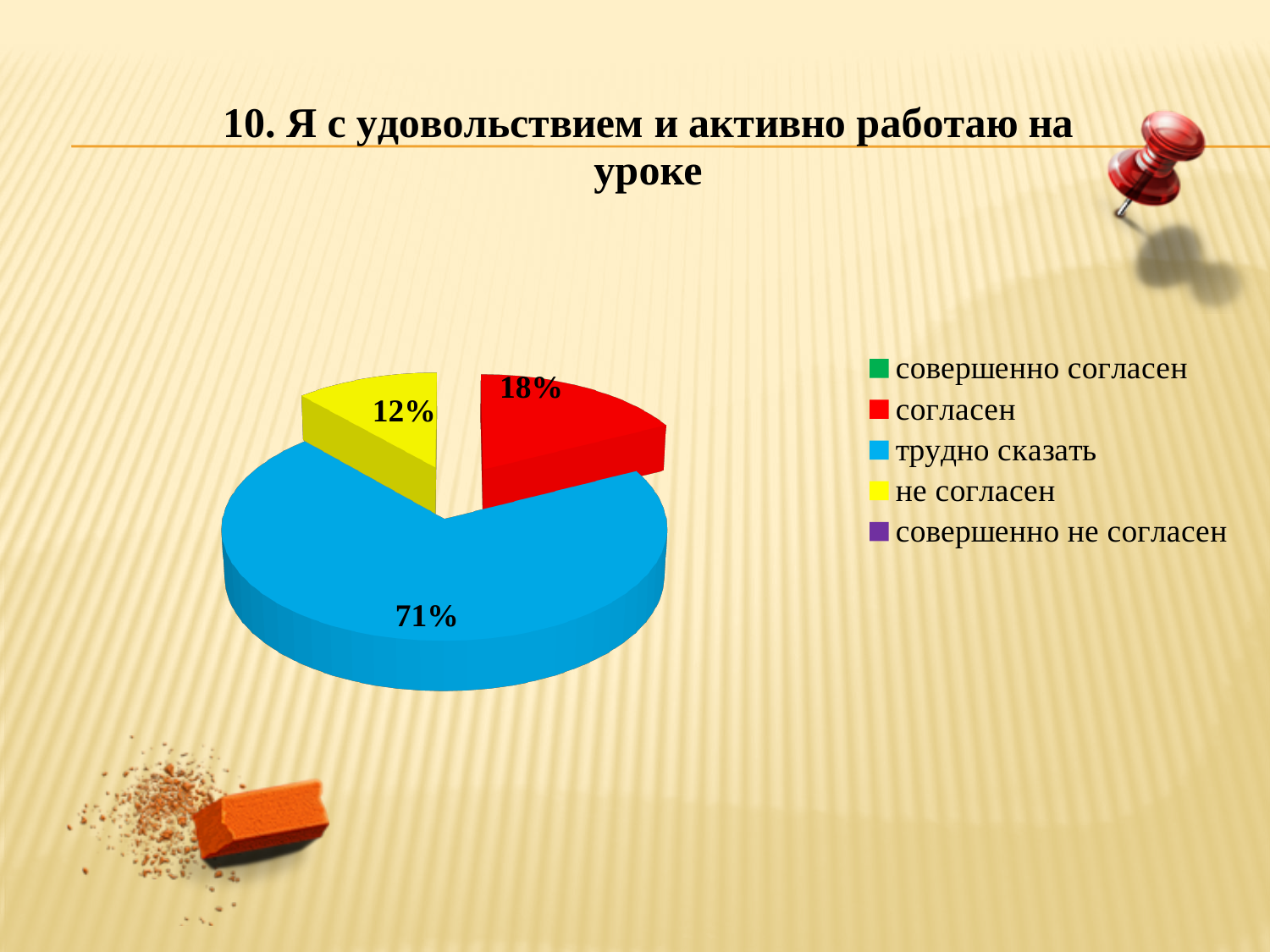
Which category has the largest slice of the pie? трудно сказать Which is larger, the slice for "согласен" or the slice for "не согласен"? согласен What is the difference between the shares for "трудно сказать" and "согласен"? 53% What share of the pie does "не согласен" have? 12% What is the difference between the shares for "согласен" and "не согласен"? 6% How many entries does the legend list? 5 What share of the pie does "трудно сказать" have? 71% Which of the labelled slices is the smallest? не согласен What kind of chart is shown on the slide? pie chart What colour is the slice for "трудно сказать"? blue What share of the pie does "согласен" have? 18% How many slices with percentage labels are visible in the pie? 3